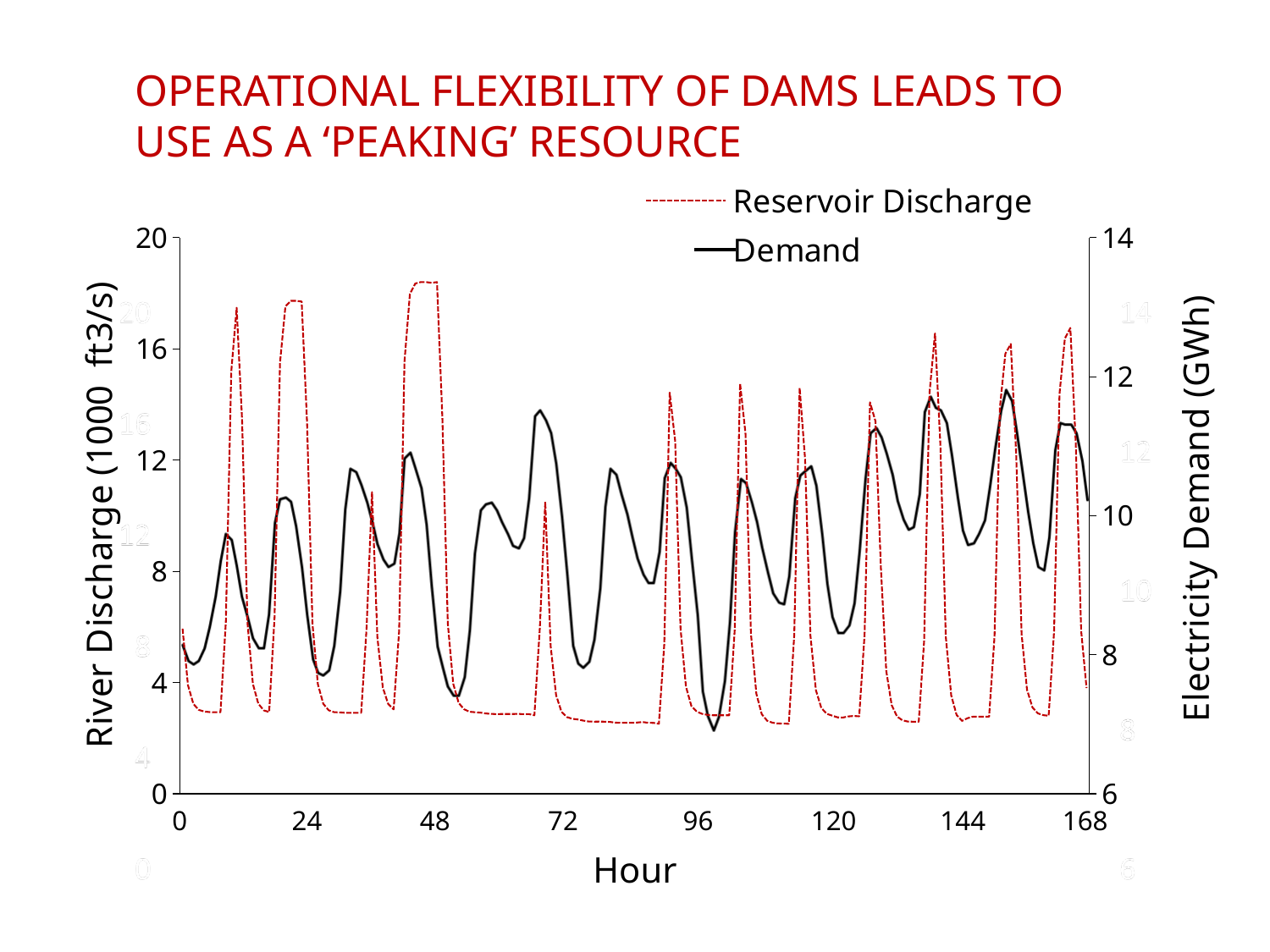
How many series does the legend list? 2 What is the title of the x axis? Hour Is the Demand peak near hour 152 greater or less than 10 GWh on the right axis? greater What are the two series named in the legend? Reservoir Discharge and Demand Which is higher: the Reservoir Discharge peak near hour 48 or the Reservoir Discharge peak near hour 96? near hour 48 Does the highest Reservoir Discharge peak occur before or after hour 72? before What is the largest value shown on the x axis? 168 Between hour 0 and hour 10, does Demand rise or fall? rise What kind of chart is shown on the slide? line chart Is the Reservoir Discharge value at hour 84 greater or less than 4 on the left axis? less Is the highest Reservoir Discharge peak (near hour 48) greater or less than 16 on the left axis? greater